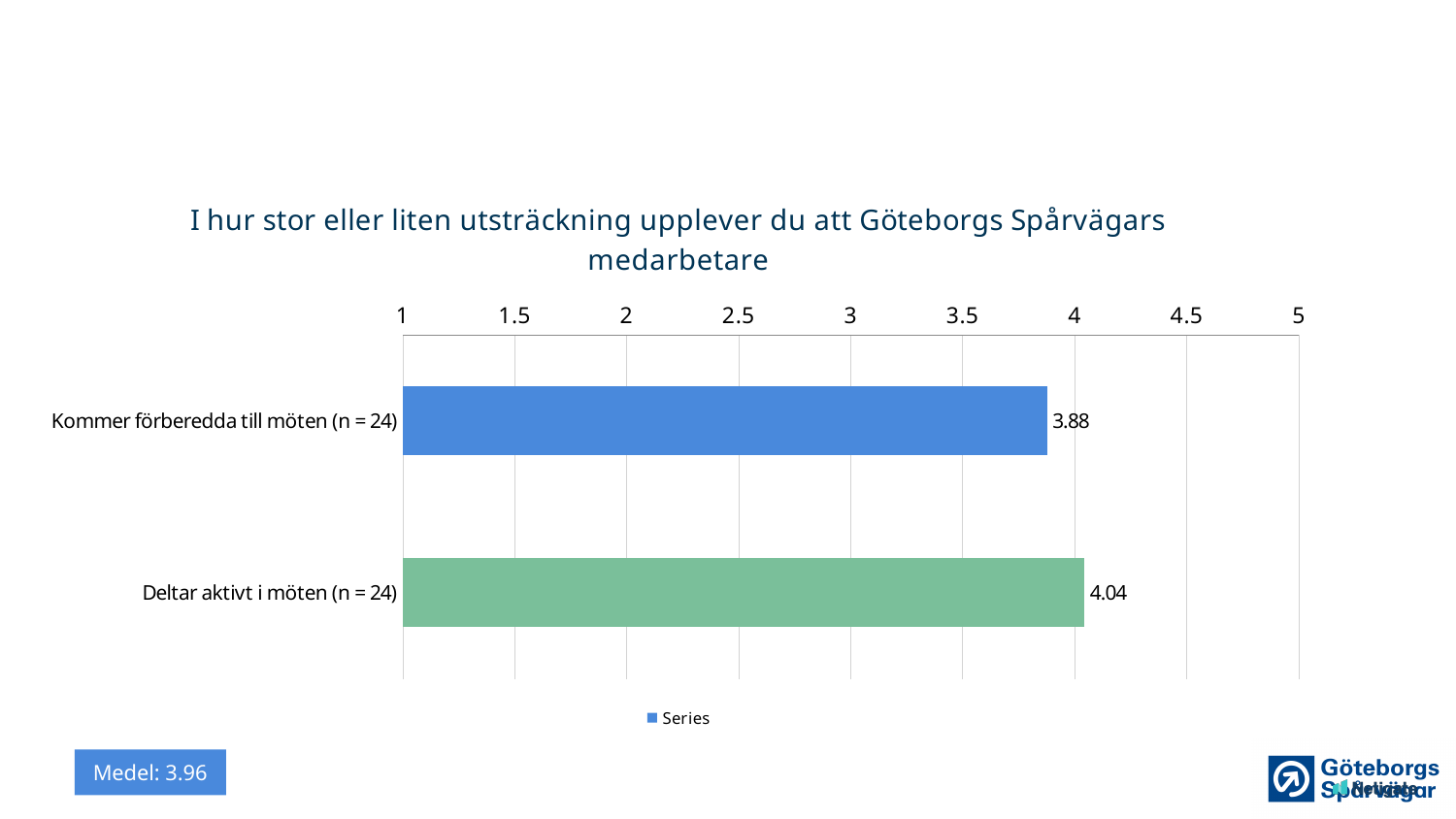
Which category has the lowest value? Kommer förberedda till möten (n = 24) What is the legend entry shown below the chart? Series What kind of chart is shown on the slide? Bar chart Is the value for "Kommer förberedda till möten (n = 24)" greater or less than 4? less Which category has the highest value? Deltar aktivt i möten (n = 24) Is the value for "Deltar aktivt i möten (n = 24)" greater or less than 4? greater What is the value for "Deltar aktivt i möten (n = 24)"? 4.04 How many series does the legend list? 1 What is the difference between the values for "Deltar aktivt i möten (n = 24)" and "Kommer förberedda till möten (n = 24)"? 0.16 What is the value for "Kommer förberedda till möten (n = 24)"? 3.88 How many categories are shown in the chart? 2 Which is larger: the value for "Kommer förberedda till möten (n = 24)" or the value for "Deltar aktivt i möten (n = 24)"? Deltar aktivt i möten (n = 24)